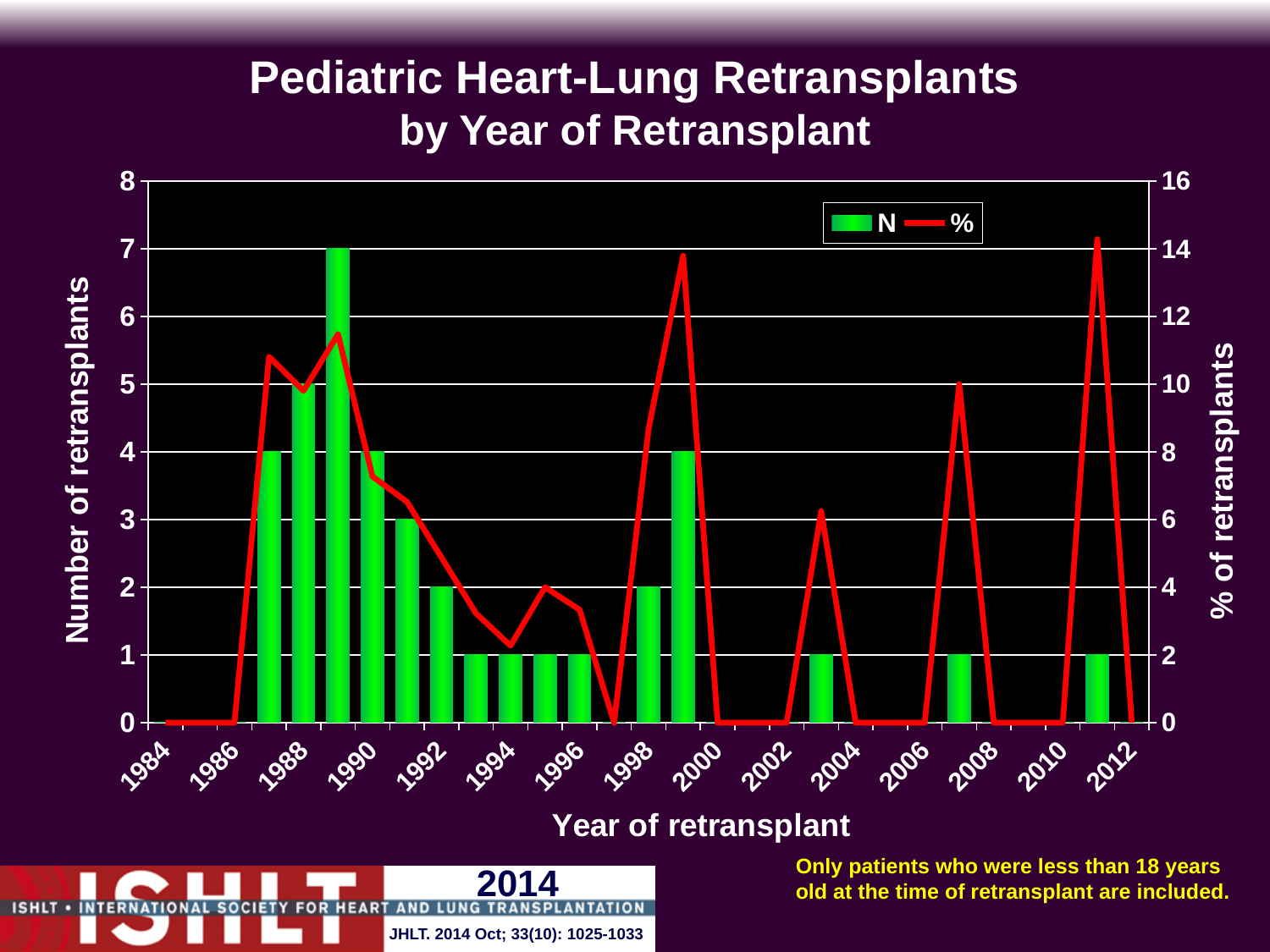
What is the title of the right-hand vertical axis? % of retransplants Is the % of retransplants in 1992 greater or less than 4? greater What is the number of retransplants in 1988? 5 What is the number of retransplants in 1990? 4 How many series does the legend list? 2 What is the number of retransplants in 1992? 2 Is the % of retransplants in 1988 greater or less than 8? greater What is the number of retransplants in 1998? 2 What is the highest number of retransplants shown by any bar? 7 What is the difference in number of retransplants between 1990 and 1992? 2 Which year has more retransplants, 1988 or 1998? 1988 What is the % of retransplants in 2006? 0